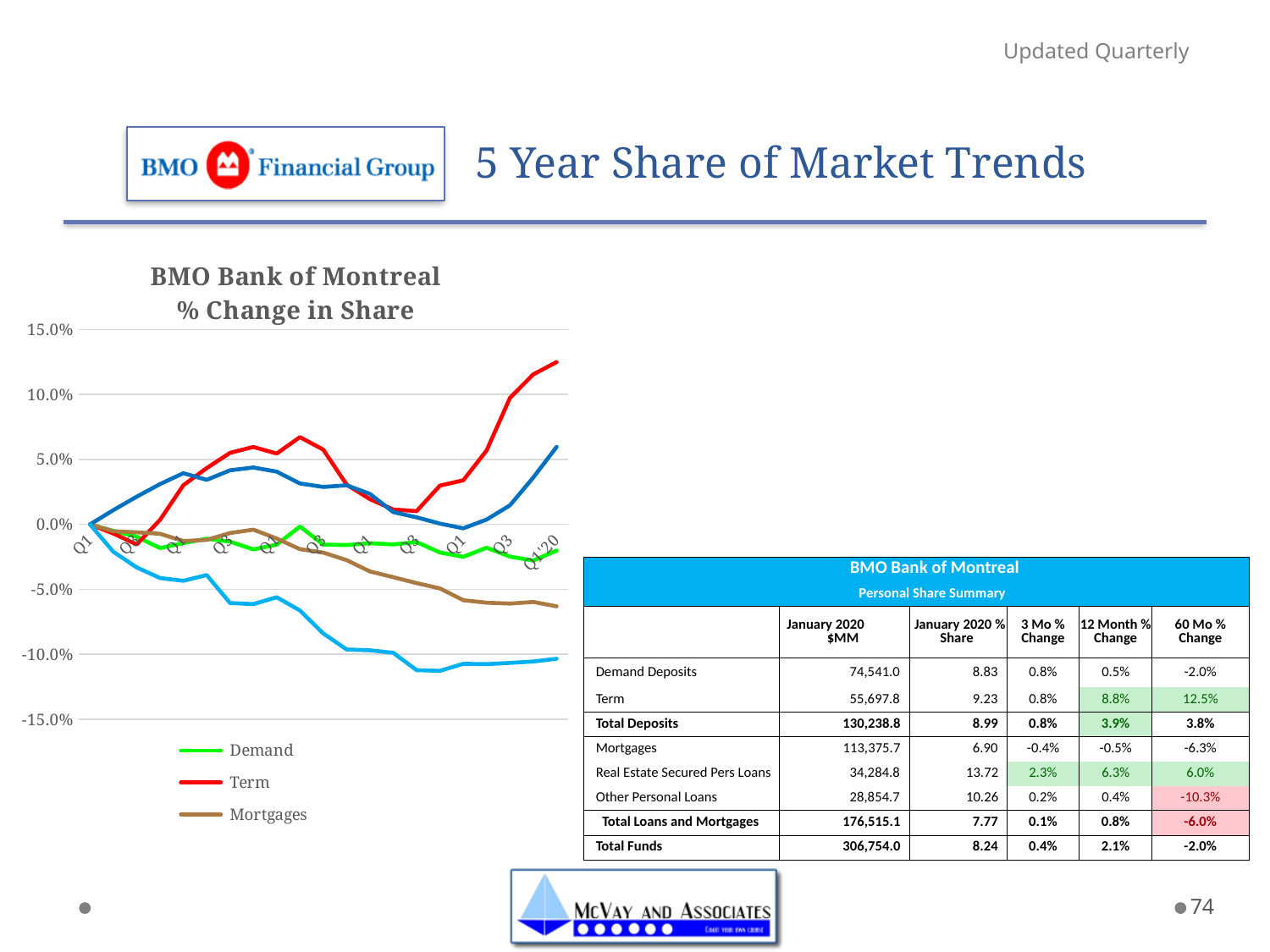
Is the value for Demand at Q1'20 greater or less than 0.0%? less What kind of chart is shown on the slide? line chart Is the value for Term at Q1'20 greater or less than 10.0%? greater Does the Term series rise or fall overall from the first quarter to Q1'20? rise Does the Mortgages series rise or fall overall from the first quarter to Q1'20? fall Is the value for Mortgages at Q1'20 greater or less than -5.0%? less At Q1'20, which is higher: Demand or Mortgages? Demand How many series does the chart's legend list? 3 Which colour is used for the Term series in the chart? red At Q1'20, which is higher: Term or Mortgages? Term What is the title of the chart on the slide? BMO Bank of Montreal % Change in Share